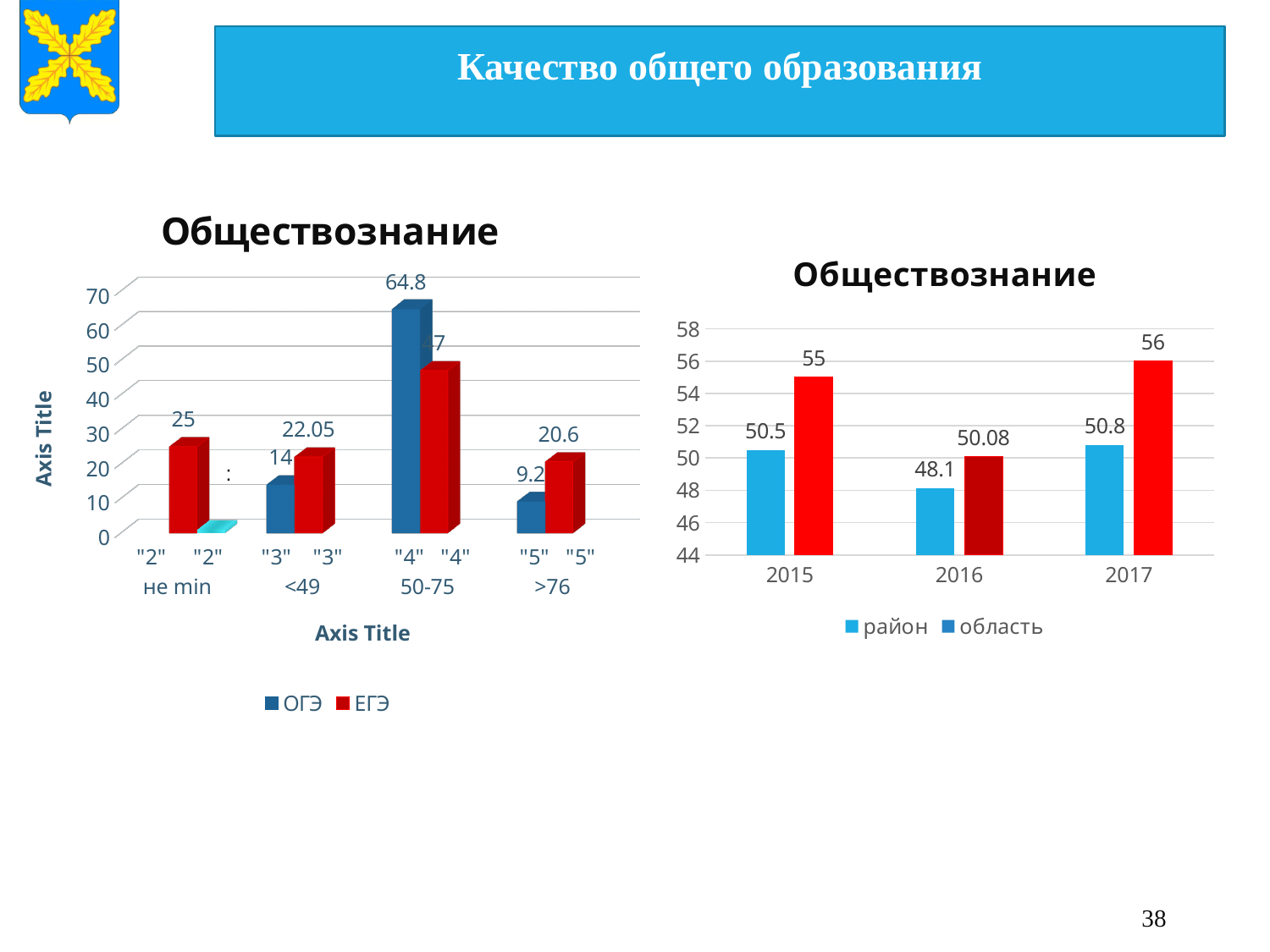
In the right-hand chart, does the value for район rise or fall from 2015 to 2016? fall In the right-hand chart, which year has the highest value for область? 2017 In the left-hand chart, what is the ЕГЭ value for the "3" (<49) category? 22.05 In the left-hand chart, which is larger for the "5" (>76) category, ОГЭ or ЕГЭ? ЕГЭ In the left-hand chart, what is the difference between the ЕГЭ and ОГЭ values for the "5" (>76) category? 11.4 In the right-hand chart, what is the value for район in 2015? 50.5 In the right-hand chart, how many series does the legend list? 2 In the left-hand chart, what is the ОГЭ value for the "4" (50-75) category? 64.8 In the right-hand chart, what is the value for область in 2016? 50.08 What type of chart is the right-hand chart? bar chart In the right-hand chart, what is the difference between область and район in 2017? 5.2 In the right-hand chart, which year has the lowest value for район? 2016